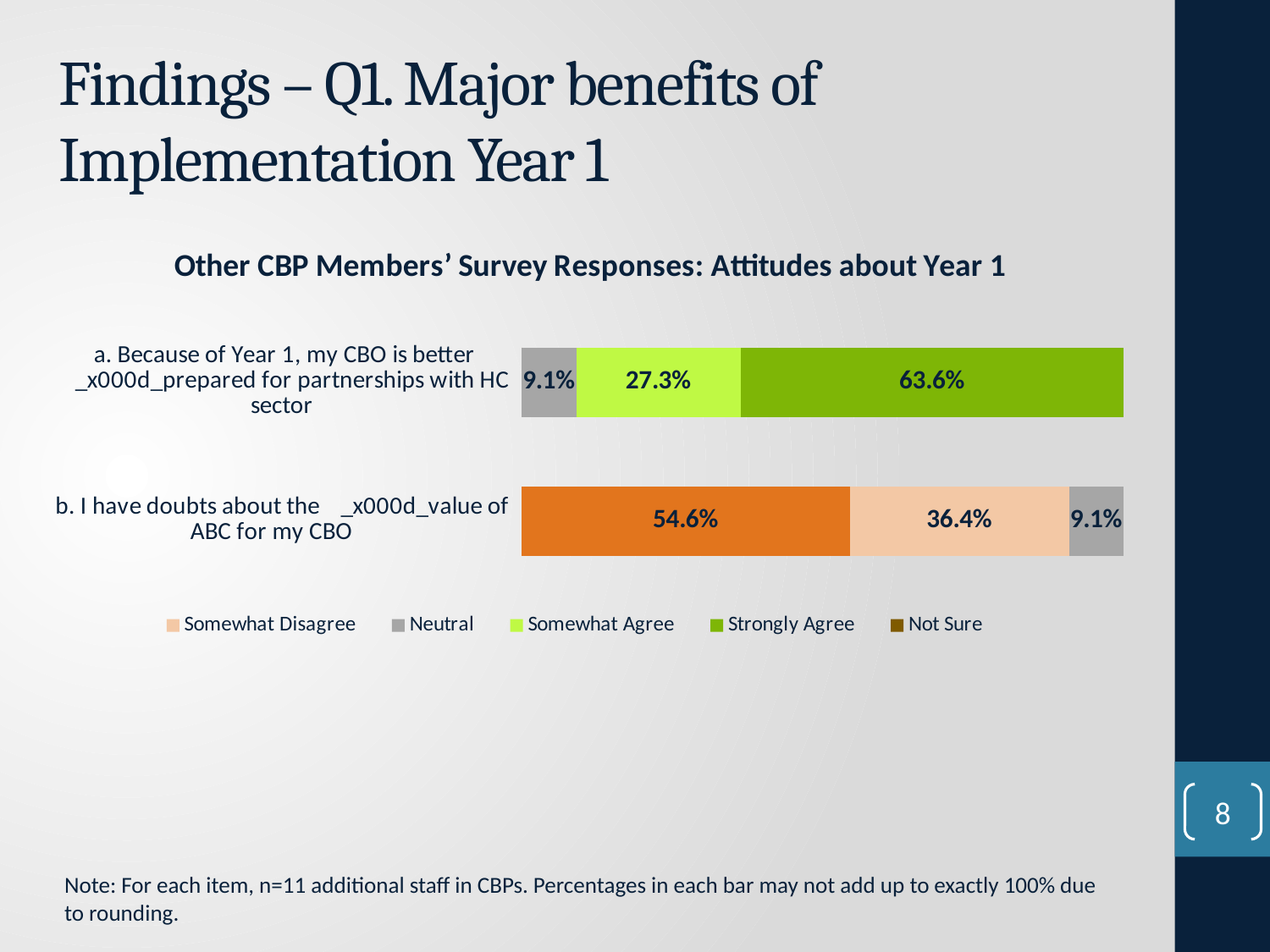
What is the title of the chart? Other CBP Members' Survey Responses: Attitudes about Year 1 What percentage of respondents chose Strongly Agree for item a (my CBO is better prepared for partnerships with HC sector)? 63.6% What kind of chart is shown on the slide? Stacked bar chart For item a, how much larger is the Strongly Agree share than the Somewhat Agree share? 36.3% What percentage of respondents chose Somewhat Disagree for item b (I have doubts about the value of ABC for my CBO)? 36.4% How many response categories does the legend list? 5 What percentage of respondents chose Somewhat Agree for item a? 27.3% What percentage of respondents were Neutral on item b? 9.1% What is the largest segment value in the bar for item b? 54.6% For item a, which is larger: the Strongly Agree share or the Somewhat Agree share? Strongly Agree How many survey items (bars) does the chart show? 2 What percentage of respondents were Neutral on item a? 9.1%